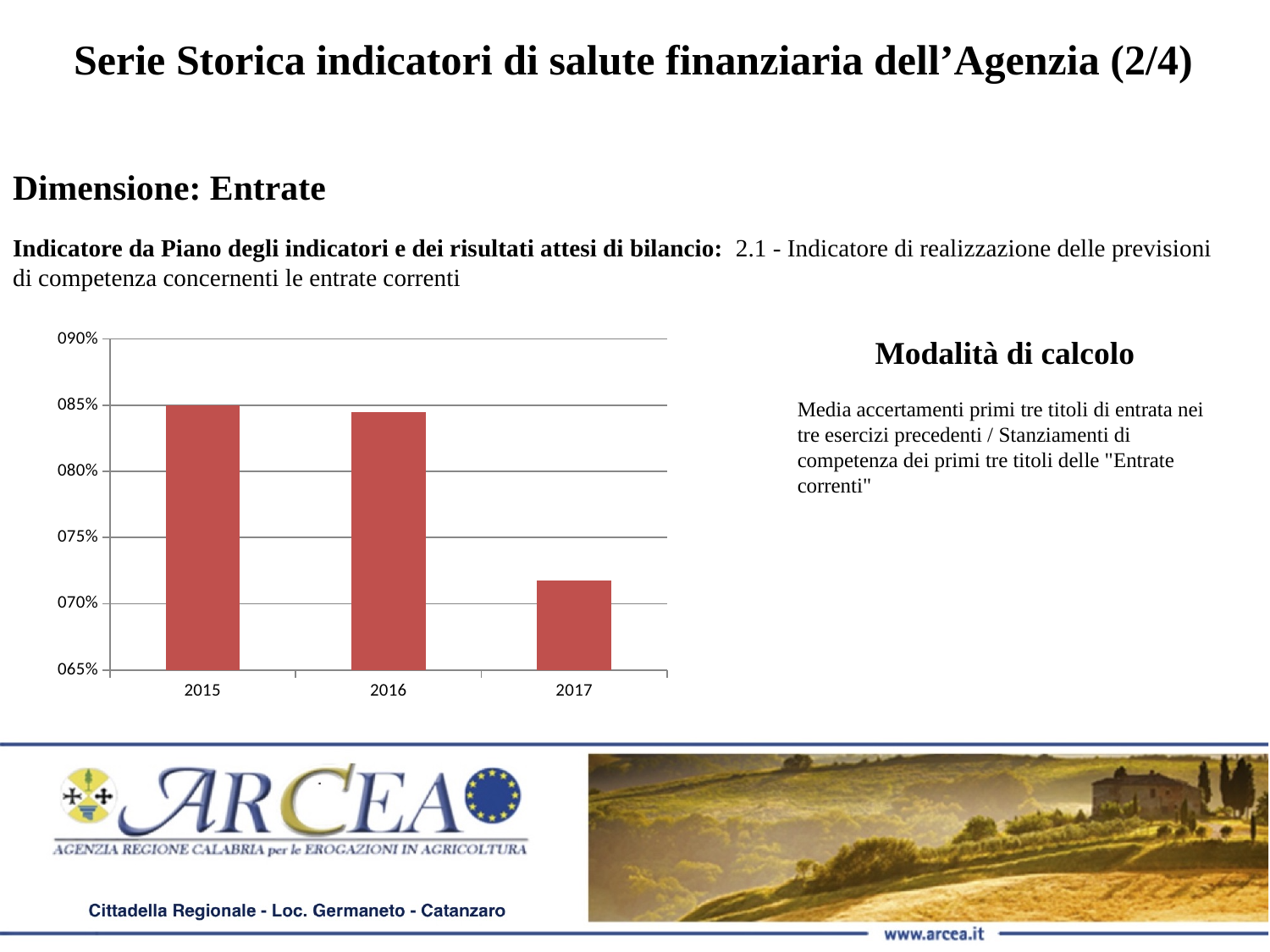
What colour are the bars in the chart? red What kind of chart is shown on the slide? bar chart Is the value for 2017 greater or less than 070%? greater Is the value for 2016 greater or less than 080%? greater How many years are shown on the x axis of the chart? 3 Is the value for 2017 greater or less than 075%? less Which year has the lowest value in the chart? 2017 Which is larger, the value for 2015 or the value for 2017? 2015 Do the values rise or fall from 2015 to 2017? fall What is the lowest value shown on the chart's vertical axis? 065% Which is larger, the value for 2016 or the value for 2017? 2016